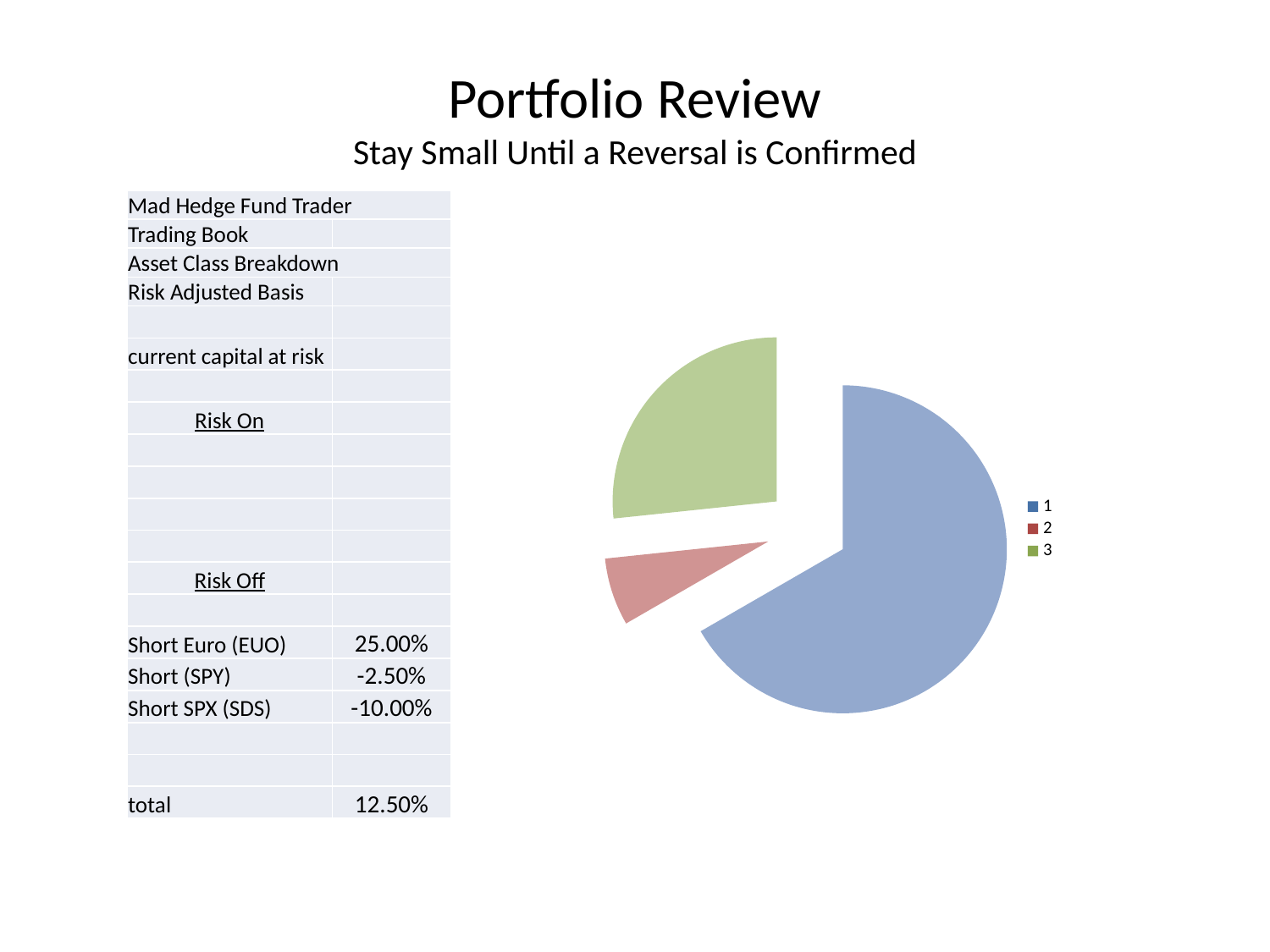
Which slice is larger in the pie chart, 1 or 3? 1 Which legend entry corresponds to the smallest slice of the pie chart? 2 What kind of chart is shown on the slide? pie chart What colour is slice 1 in the pie chart? blue What entries does the legend of the pie chart list? 1, 2, 3 How many slices does the pie chart have? 3 Which slice is larger in the pie chart, 2 or 3? 3 Which legend entry corresponds to the largest slice of the pie chart? 1